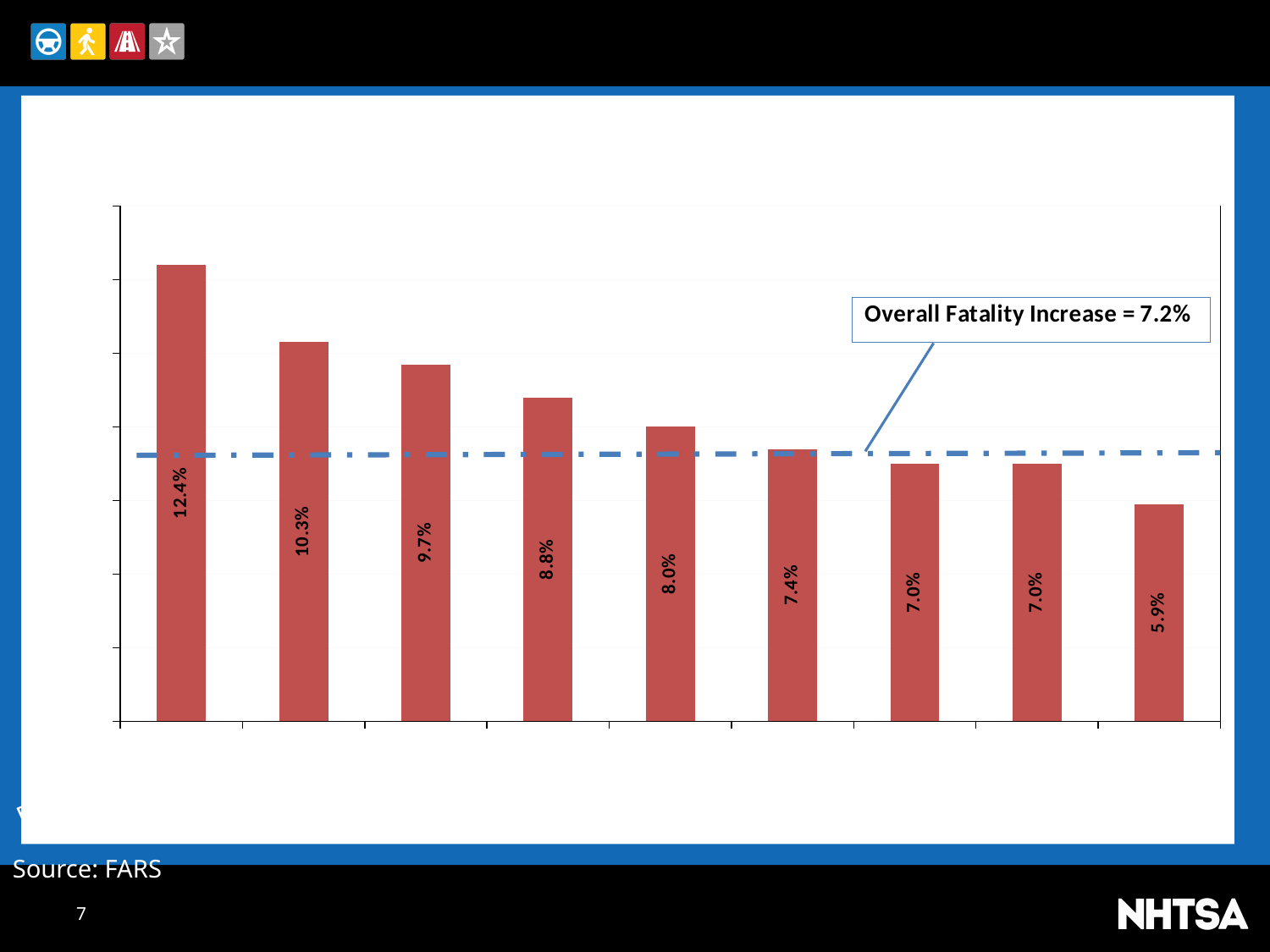
Which is larger, the second bar from the left or the third bar from the left? the second bar from the left (10.3%) What is the value shown on the fourth bar from the left? 8.8% What is the value shown on the rightmost bar? 5.9% How many bars are plotted in the chart? 9 What is the lowest value labelled on any bar? 5.9% What is the highest value labelled on any bar? 12.4% What kind of chart is shown on the slide? bar chart Do the bar values rise or fall from left to right across the chart? fall What value does the dashed horizontal line represent, according to the annotation? Overall Fatality Increase = 7.2% What is the value shown on the leftmost bar? 12.4% How many bars have a value below the 7.2% overall fatality increase line? 3 What is the difference between the leftmost bar (12.4%) and the rightmost bar (5.9%)? 6.5%